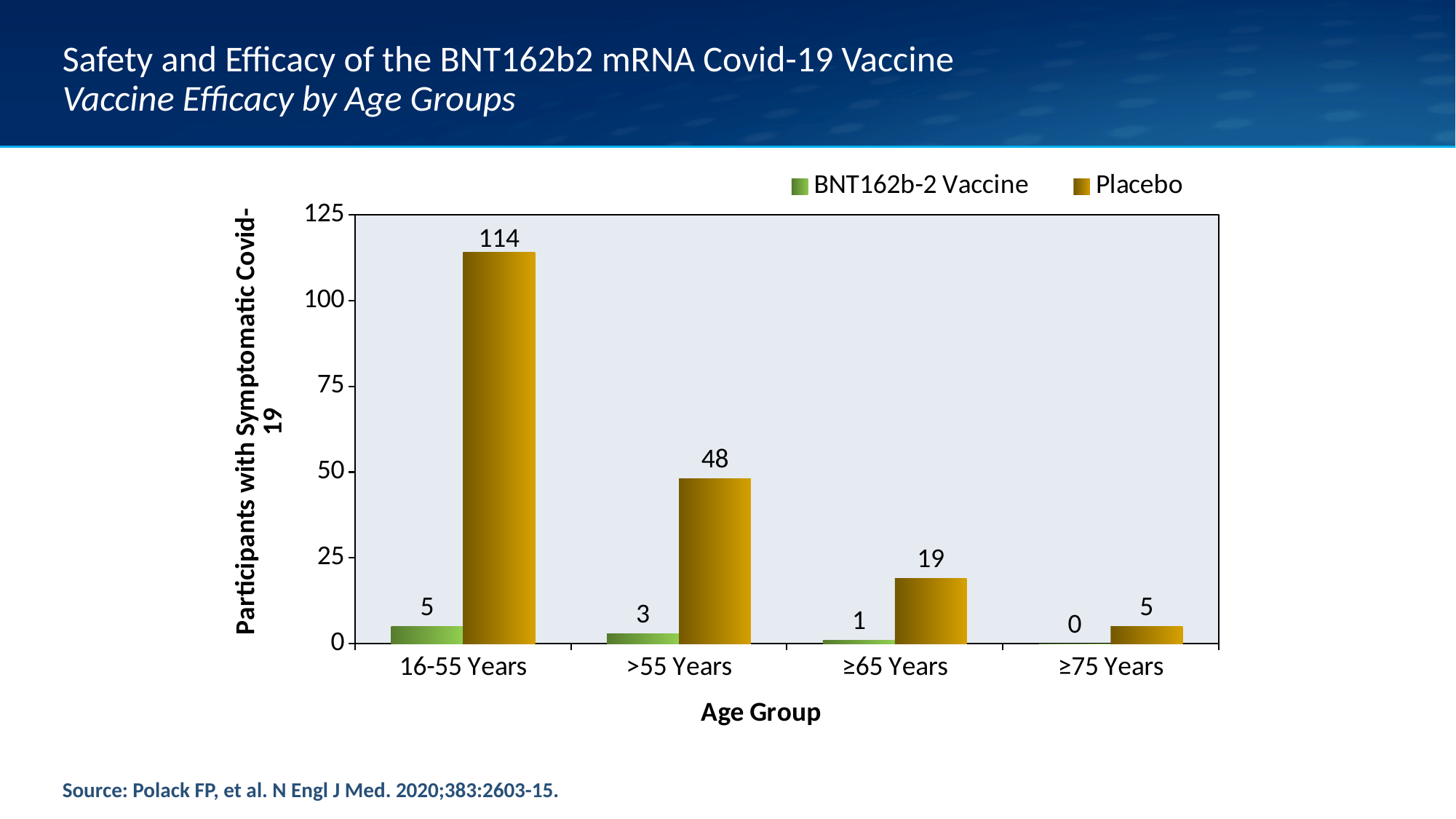
How many age groups are shown on the x axis? 4 Do the Placebo values rise or fall from 16-55 Years to ≥75 Years? fall What kind of chart is shown on the slide? bar chart What is the difference between the Placebo and BNT162b-2 Vaccine values for the ≥65 Years age group? 18 How many series does the legend list? 2 Which age group has the highest Placebo value? 16-55 Years How many participants with symptomatic Covid-19 were in the BNT162b-2 Vaccine group for the >55 Years age group? 3 Which age group has the lowest BNT162b-2 Vaccine value? ≥75 Years Is the Placebo value for the 16-55 Years age group greater or less than 100? greater How many participants with symptomatic Covid-19 were in the Placebo group for the 16-55 Years age group? 114 Which is larger for the >55 Years age group: the BNT162b-2 Vaccine value or the Placebo value? Placebo What is the Placebo value for the ≥75 Years age group? 5